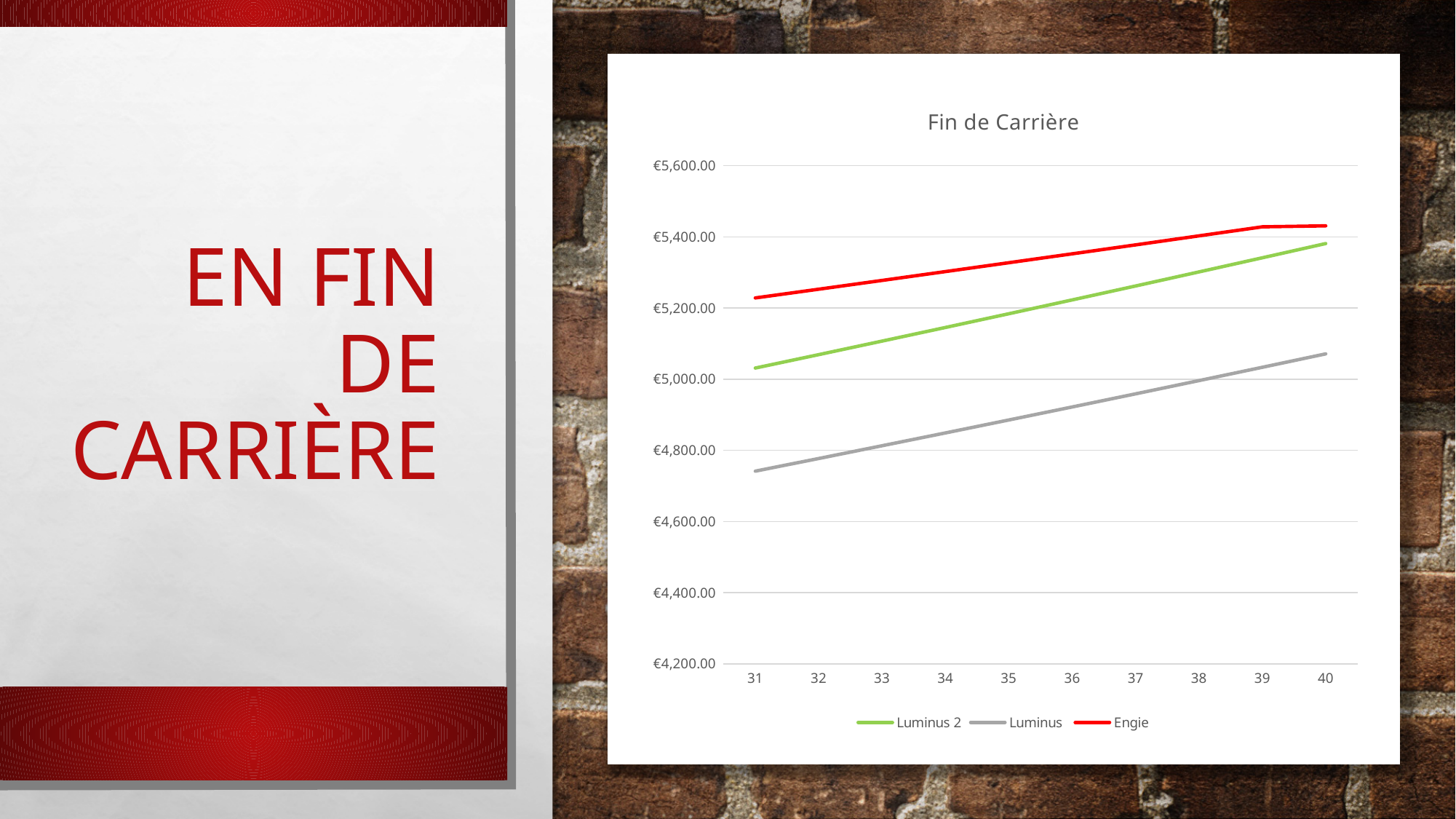
Which series has the highest value at 40? Engie How many series does the legend list? 3 At 35, which is larger: the value for Engie or the value for Luminus? Engie Is the value for Engie at 31 greater or less than €5,200.00? greater Which series has the lowest value at 31? Luminus What is the title of the chart? Fin de Carrière Is the value for Luminus 2 at 40 greater or less than €5,400.00? less What type of chart is shown on the slide? line chart How many points are on the x axis of the chart? 10 Do the values for Luminus rise or fall from 31 to 40? rise Is the value for Luminus at 40 greater or less than €5,000.00? greater